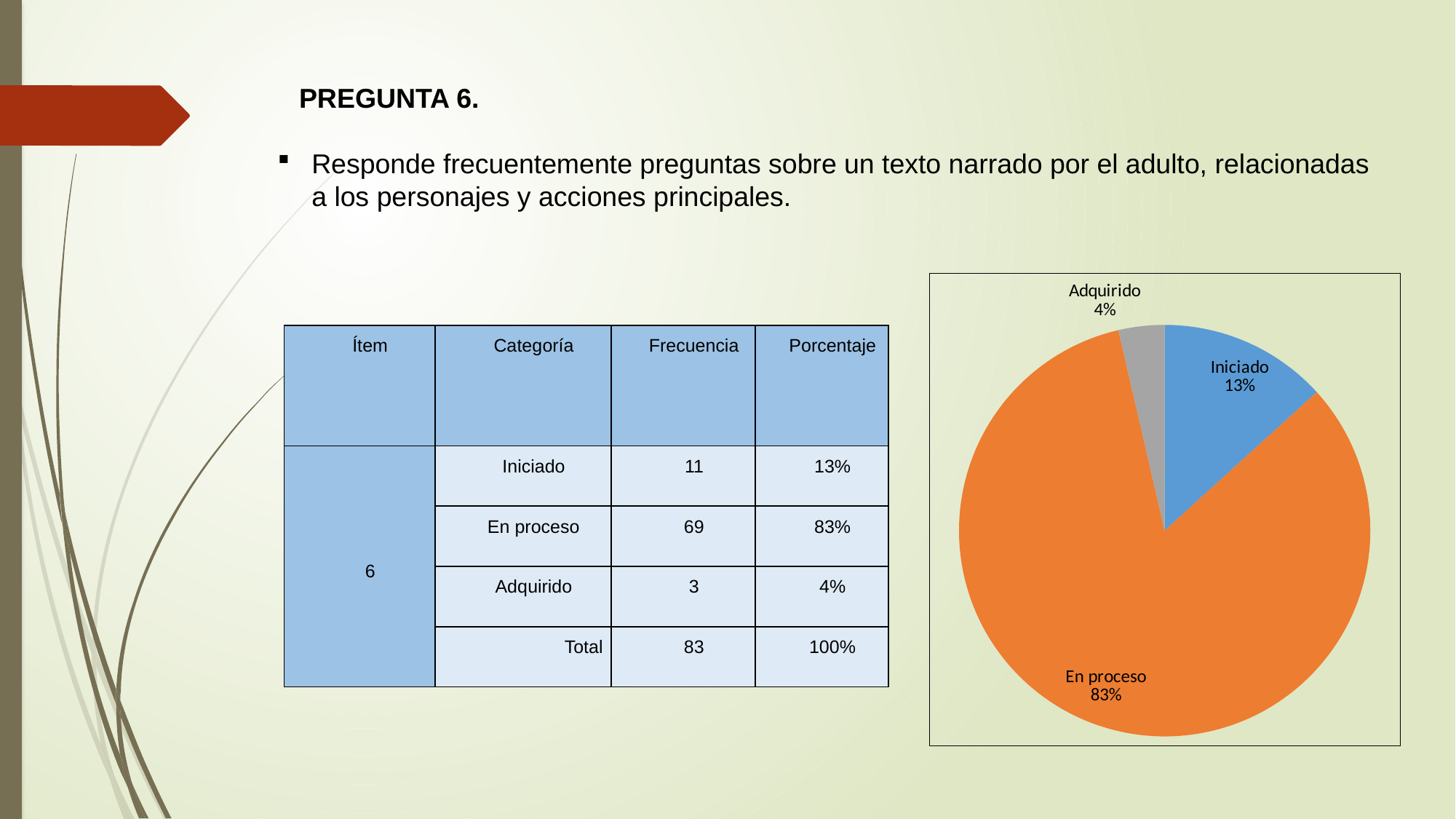
Which category has the smallest slice of the pie? Adquirido What share of the pie does the Iniciado slice represent? 13% What is the difference in percentage points between the Iniciado slice and the Adquirido slice? 9% What is the difference in percentage points between the En proceso slice and the Iniciado slice? 70% What share of the pie does the Adquirido slice represent? 4% What colour is the Iniciado slice of the pie chart? blue Which category has the largest slice of the pie? En proceso Which slice is larger, Iniciado or Adquirido? Iniciado How many slices does the pie chart have? 3 What kind of chart is shown on the slide? pie chart What colour is the En proceso slice of the pie chart? orange What share of the pie does the En proceso slice represent? 83%